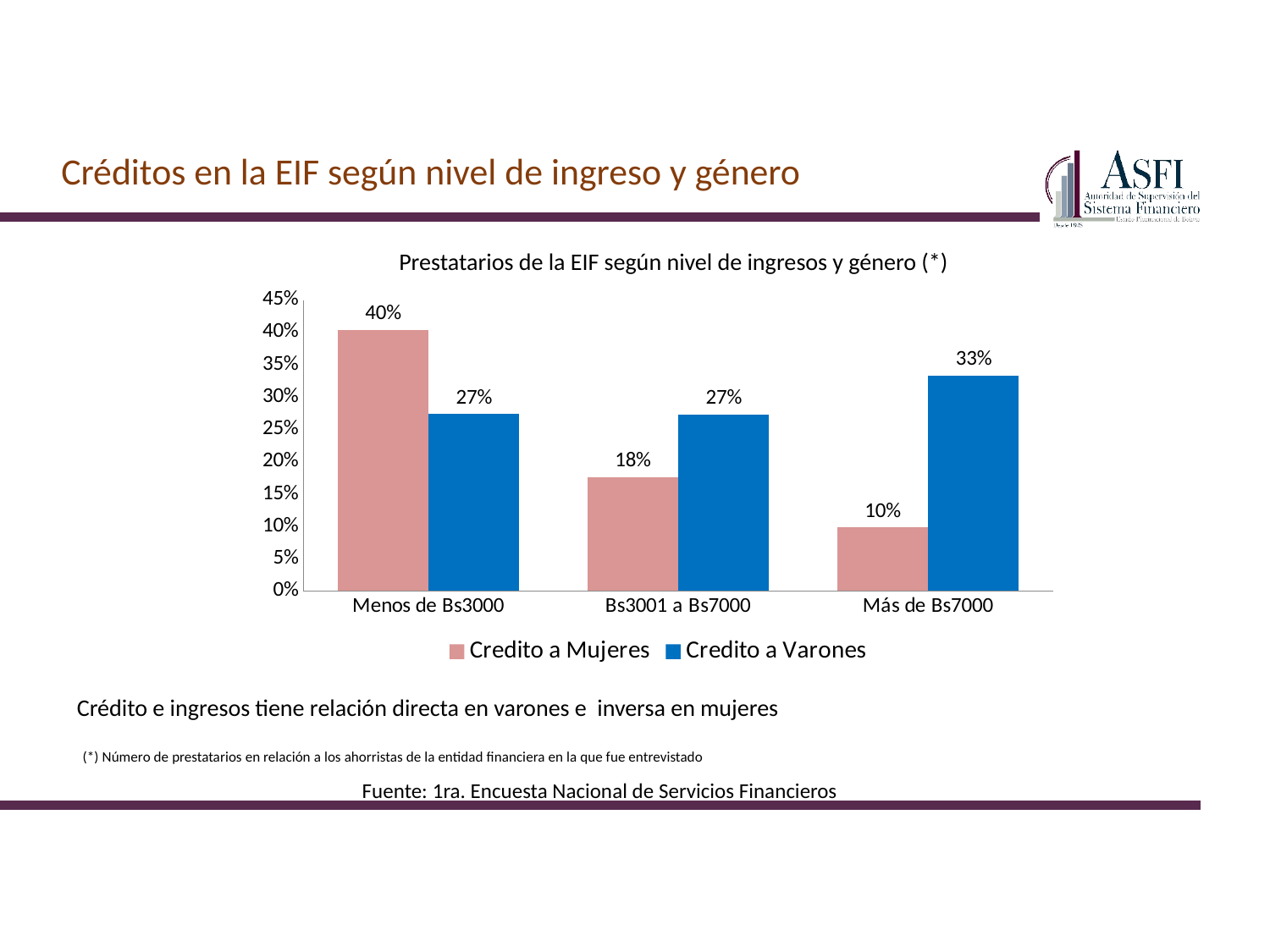
What is the value for Credito a Mujeres in the Menos de Bs3000 category? 40% What is the difference between Credito a Mujeres and Credito a Varones in the Menos de Bs3000 category? 13% What kind of chart is shown on the slide? Bar chart What is the value for Credito a Mujeres in the Bs3001 a Bs7000 category? 18% Which income category has the highest value for Credito a Mujeres? Menos de Bs3000 What is the title of the chart? Prestatarios de la EIF según nivel de ingresos y género (*) How many series does the legend list? 2 Which income category has the lowest value for Credito a Varones? Menos de Bs3000 and Bs3001 a Bs7000 (both 27%) In the Más de Bs7000 category, which is larger: Credito a Mujeres or Credito a Varones? Credito a Varones How many income categories are shown on the x axis? 3 Do the values for Credito a Mujeres rise or fall as income level increases along the x axis? Fall What is the value for Credito a Varones in the Más de Bs7000 category? 33%